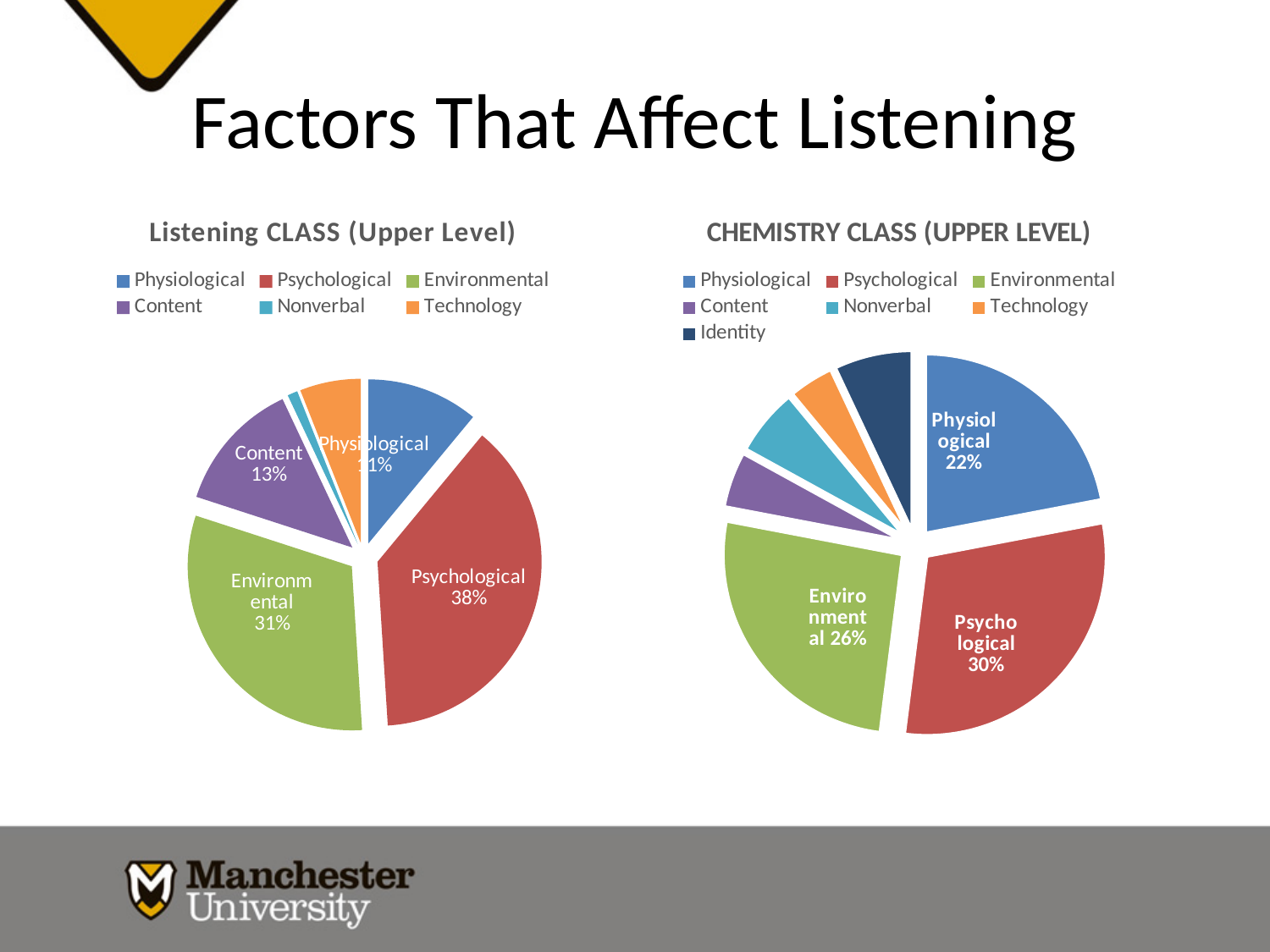
In the CHEMISTRY CLASS (UPPER LEVEL) chart, what share does Physiological have? 22% In the CHEMISTRY CLASS (UPPER LEVEL) chart, what share does Environmental have? 26% In the Listening CLASS (Upper Level) chart, how many percentage points larger is Psychological than Environmental? 7 percentage points In the Listening CLASS (Upper Level) chart, what share does Environmental have? 31% In the CHEMISTRY CLASS (UPPER LEVEL) chart, what share does Psychological have? 30% In the Listening CLASS (Upper Level) chart, which factor has the largest slice? Psychological What kind of chart is the Listening CLASS (Upper Level) chart on the left? pie chart In the Listening CLASS (Upper Level) chart, what share does Psychological have? 38% How many entries does the legend of the Listening CLASS (Upper Level) chart list? 6 In the CHEMISTRY CLASS (UPPER LEVEL) chart, which is larger, Physiological or Environmental? Environmental In the Listening CLASS (Upper Level) chart, what share does Content have? 13% How many entries does the legend of the CHEMISTRY CLASS (UPPER LEVEL) chart list? 7